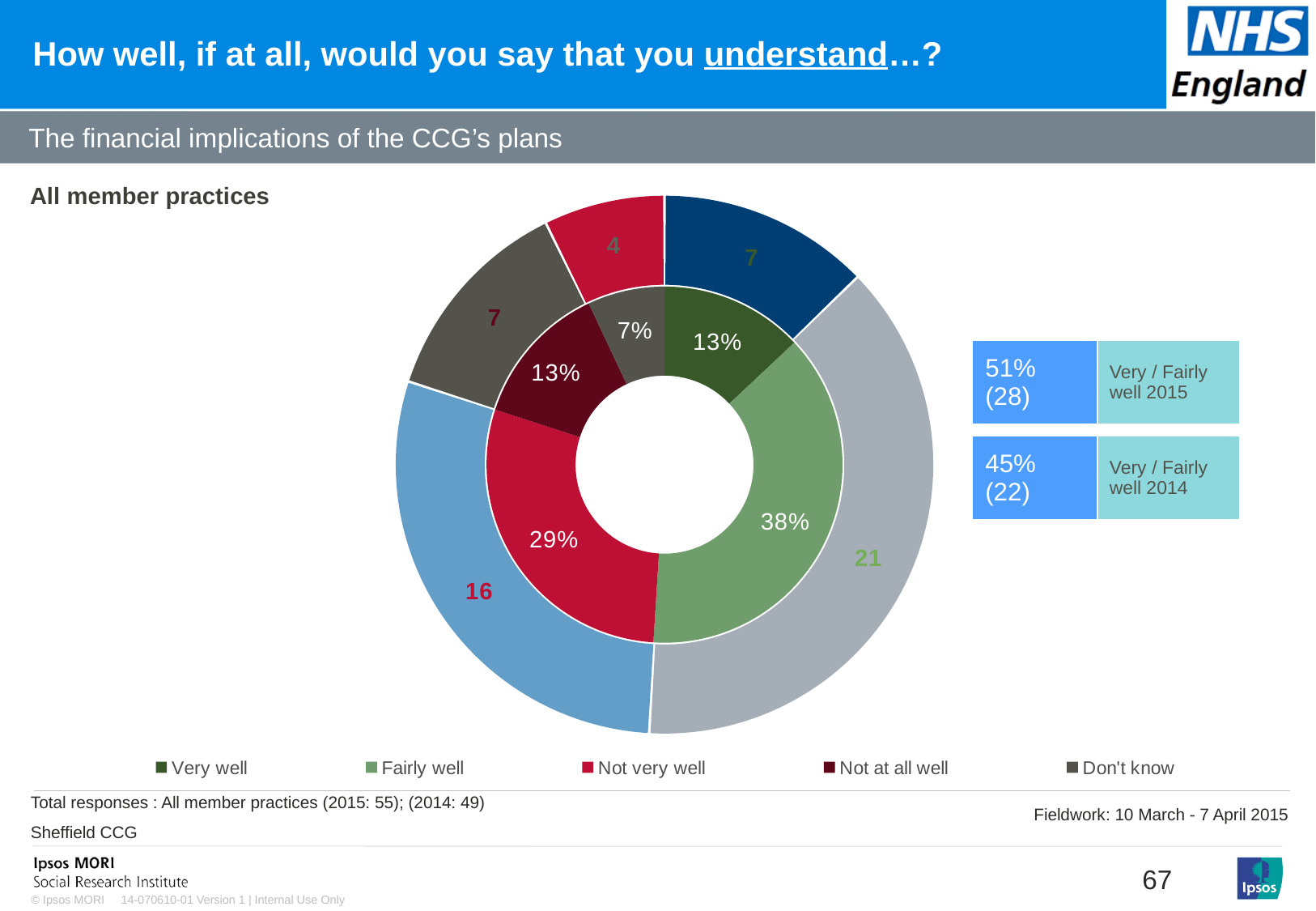
What type of chart is shown on the slide? Doughnut chart Which response category has the largest share in the inner ring? Fairly well What percentage of member practices answered 'Don't know'? 7% What was the 'Very / Fairly well' percentage in 2014, as shown in the box to the right of the chart? 45% How many categories does the legend list? 5 Which is larger, the share for 'Not very well' or the share for 'Not at all well'? Not very well What percentage of member practices answered 'Very well'? 13% What percentage of member practices said they understand the financial implications of the CCG's plans 'Fairly well'? 38% What is the difference in percentage points between 'Fairly well' and 'Not very well'? 9 percentage points What percentage of member practices answered 'Not very well'? 29% Which response category has the smallest share in the inner ring? Don't know What is the combined percentage for 'Very well' and 'Fairly well' in 2015, as shown in the box to the right of the chart? 51%